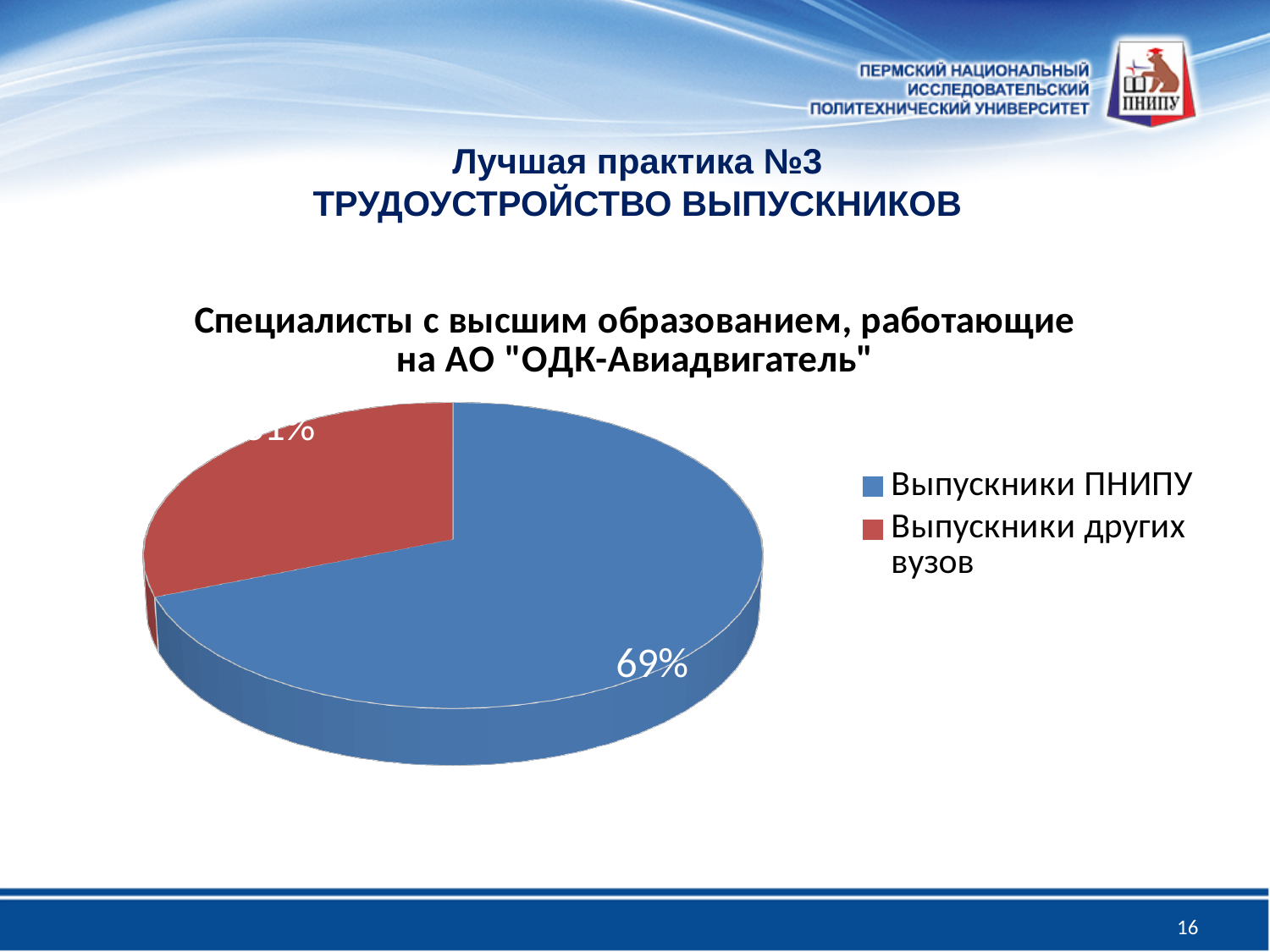
What percentage is shown on the blue slice of the pie? 69% What is the title of the chart? Специалисты с высшим образованием, работающие на АО "ОДК-Авиадвигатель" What kind of chart is shown on the slide? Pie chart Which category has the largest slice of the pie? Выпускники ПНИПУ How many slices does the pie chart have? 2 What share of the pie is labelled for Выпускники ПНИПУ? 69% Which colour represents Выпускники других вузов in the pie chart? Red How many entries does the legend list? 2 Which is larger: the slice for Выпускники ПНИПУ or the slice for Выпускники других вузов? Выпускники ПНИПУ Which category has the smallest slice of the pie? Выпускники других вузов